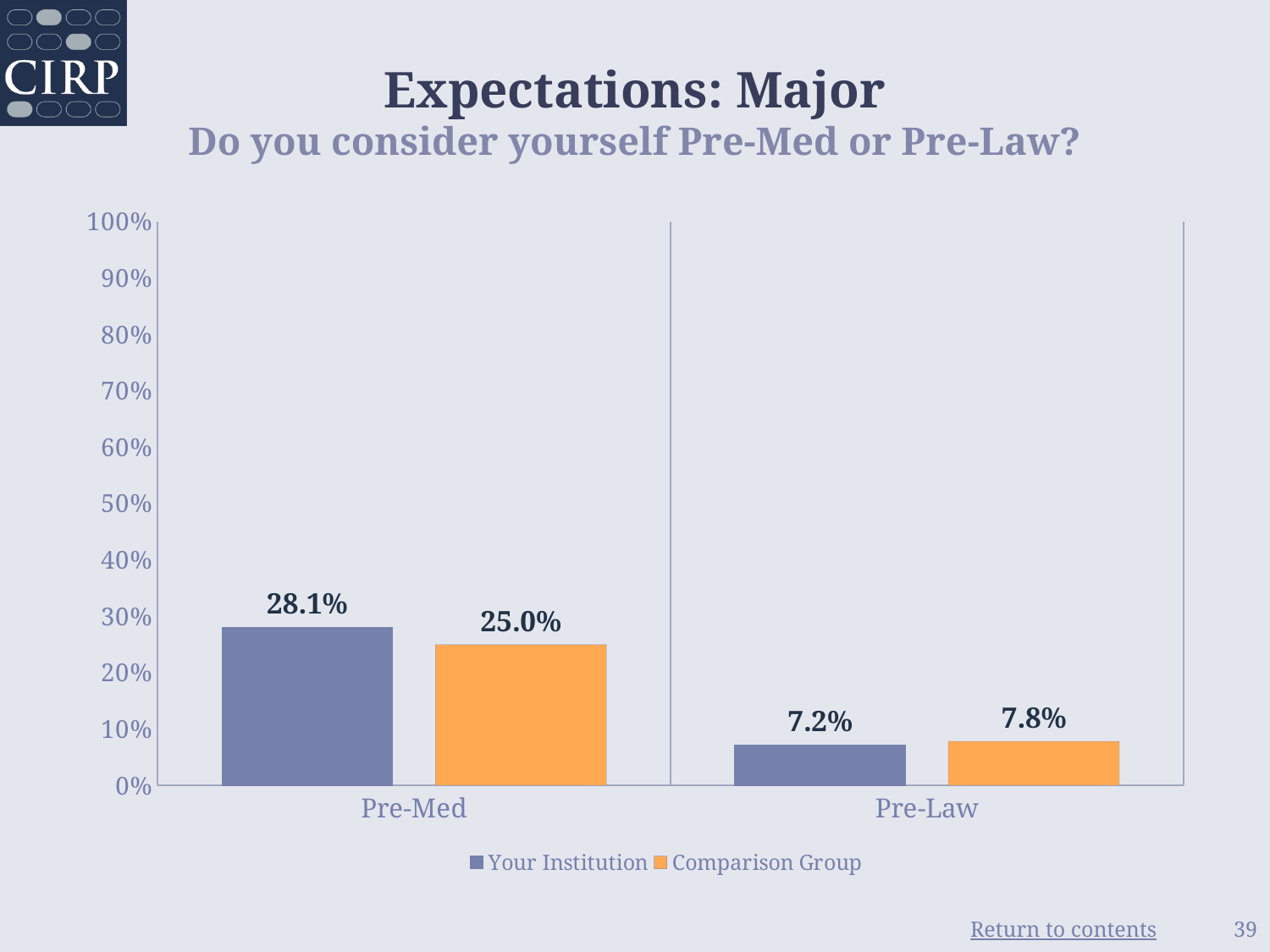
What is the Your Institution value for Pre-Law? 7.2% How many series does the legend list? 2 How many categories are shown on the x axis? 2 What kind of chart is shown on the slide? Bar chart What is the difference between the Comparison Group and Your Institution for Pre-Law? 0.6% For Pre-Law, which is larger: Your Institution or the Comparison Group? Comparison Group What percentage of Your Institution students consider themselves Pre-Med? 28.1% Which bar has the highest value on the chart? Your Institution, Pre-Med What is the Comparison Group value for Pre-Med? 25.0% Which bar has the lowest value on the chart? Your Institution, Pre-Law What is the Comparison Group value for Pre-Law? 7.8% What is the difference between Your Institution and the Comparison Group for Pre-Med? 3.1%